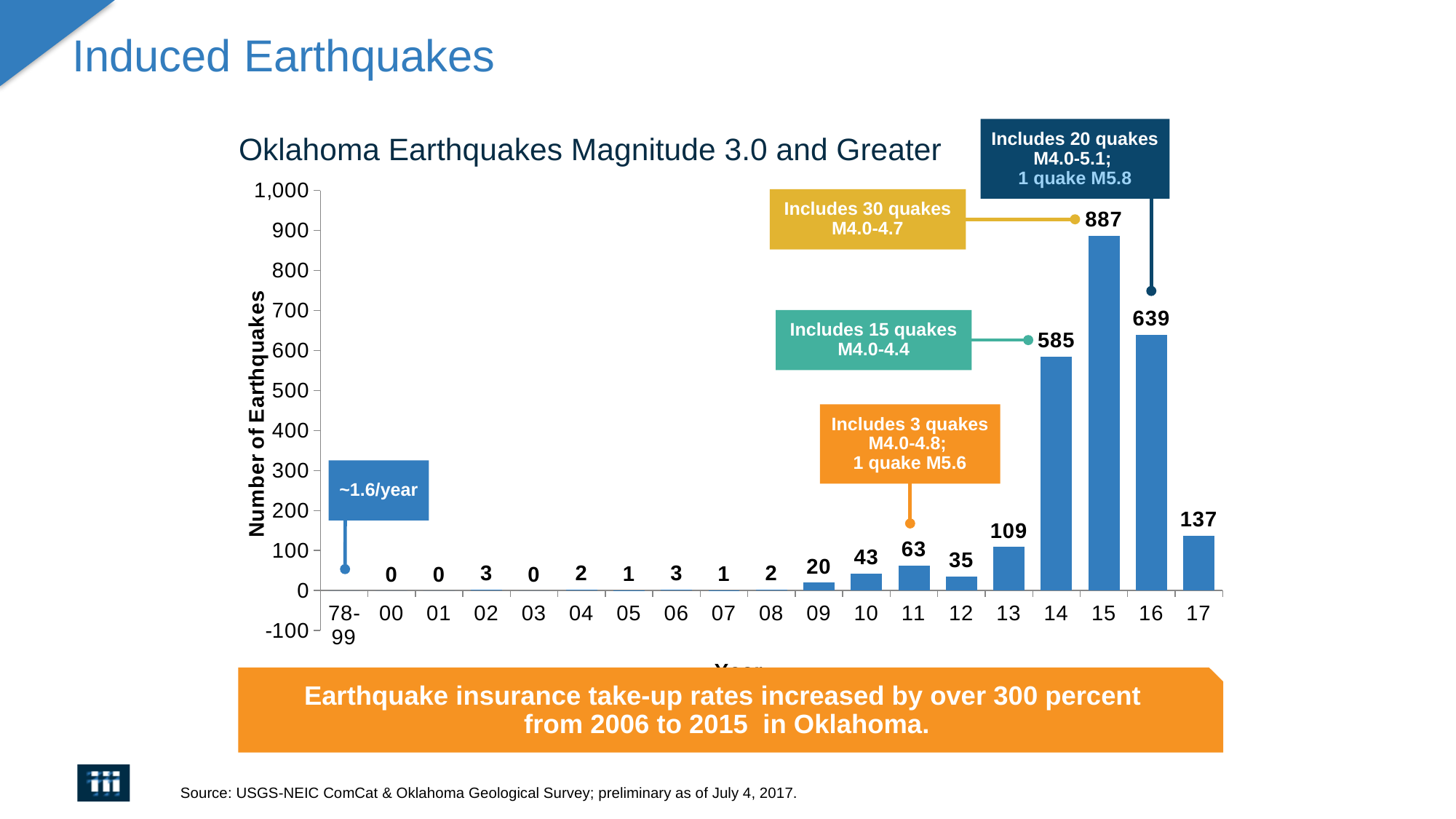
What is the title of the chart? Oklahoma Earthquakes Magnitude 3.0 and Greater How many earthquakes are shown for 11? 63 How many year categories are shown on the x axis? 19 How many earthquakes are shown for 13? 109 Which has more earthquakes, 12 or 10? 10 Which year has the highest number of earthquakes? 15 What type of chart is shown on the slide? Bar chart How many earthquakes are shown for 15? 887 What is the difference in the number of earthquakes between 15 and 16? 248 What is the difference in the number of earthquakes between 14 and 13? 476 Is the value for 16 greater or less than 600? greater What is the label on the y axis? Number of Earthquakes